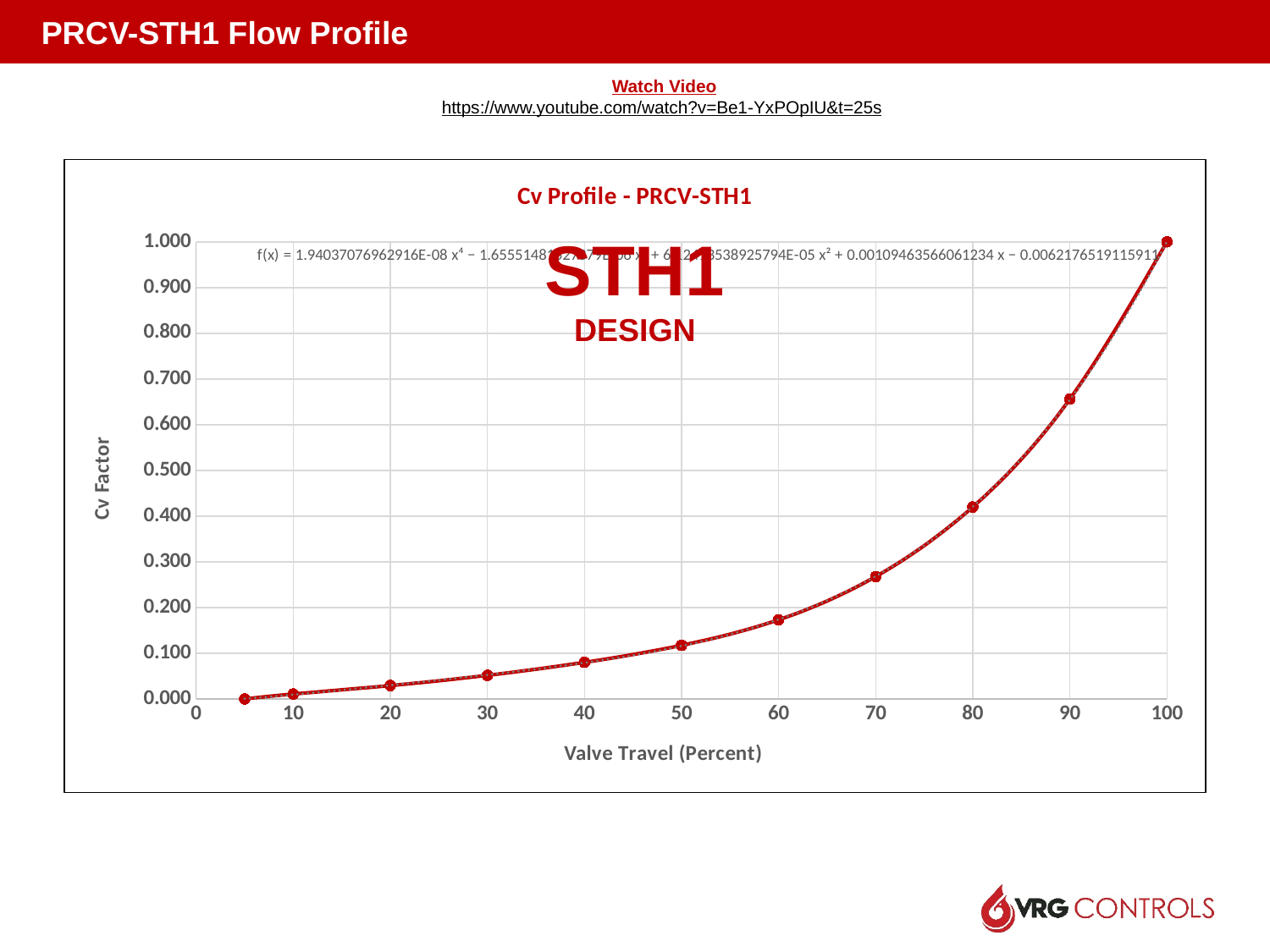
How many data points are plotted on the line? 11 Is the Cv Factor at 40 percent valve travel greater or less than 0.100? less Is the Cv Factor at 80 percent valve travel greater or less than 0.400? greater What is the label of the x axis? Valve Travel (Percent) Do the Cv Factor values rise or fall as Valve Travel increases along the x axis? rise Is the Cv Factor at 70 percent valve travel greater or less than 0.300? less What is the title of the chart? Cv Profile - PRCV-STH1 What is the Cv Factor at 100 percent valve travel? 1.000 At which Valve Travel percentage is the Cv Factor highest? 100 What kind of chart is shown on the slide? line chart Which has the larger Cv Factor: 60 percent or 80 percent valve travel? 80 percent